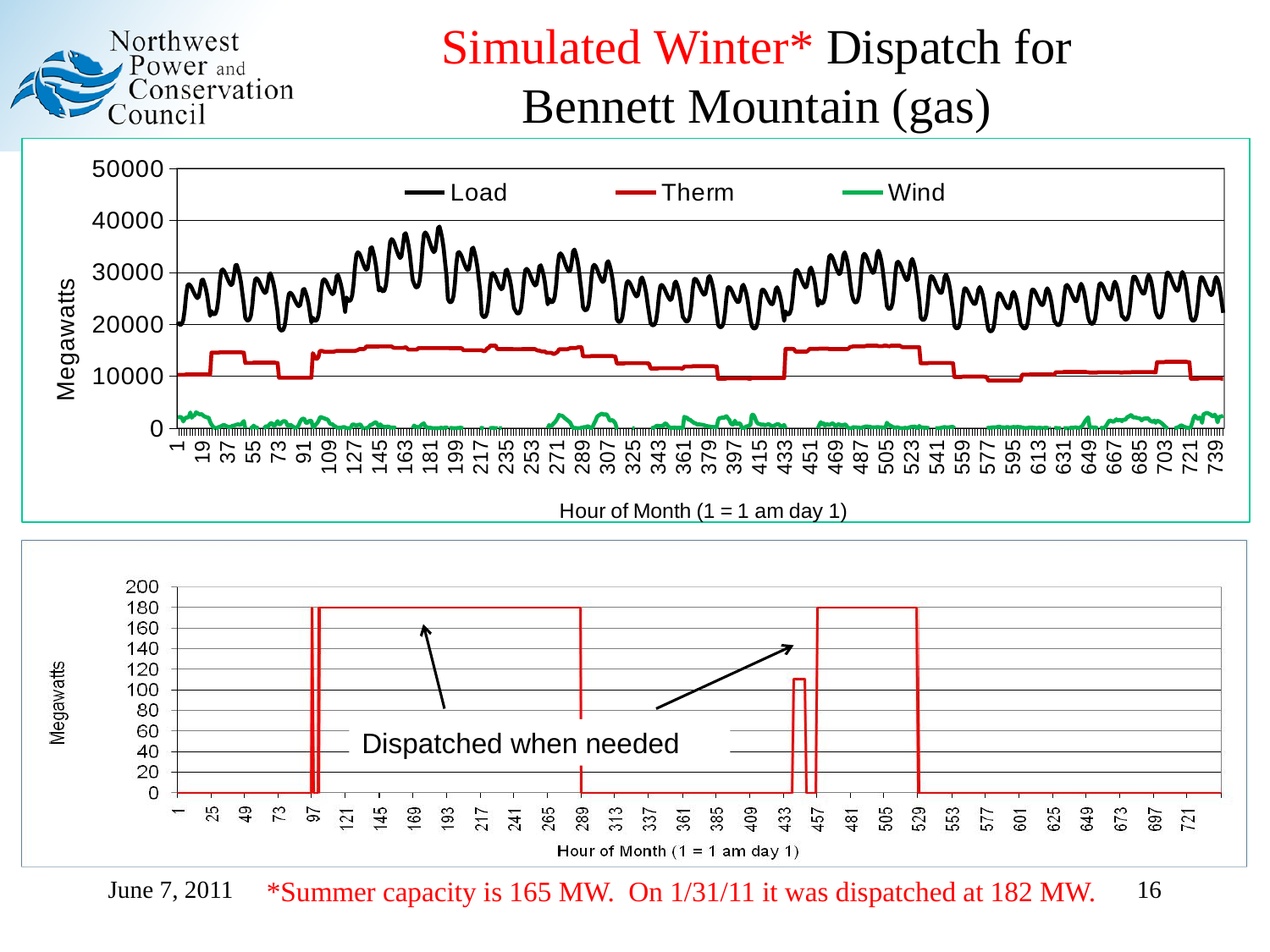
In the top chart, is the Wind value at hour 289 greater or less than 10000? less In the top chart, which series has the lowest values throughout the month? Wind In the top chart, which is larger at hour 469, Load or Therm? Load In the bottom chart, what is the dispatched value at hour 601? 0 In the top chart, is the Therm value at hour 181 greater or less than 20000? less In the top chart, which series has the highest values throughout the month, Load, Therm or Wind? Load How many series does the legend of the top chart list? 3 What is the x-axis title of the bottom chart? Hour of Month (1 = 1 am day 1) In the bottom chart, is the dispatched value at hour 193 greater or less than 160? greater In the top chart, which series is plotted in green? Wind What kind of chart is the top chart on the slide? line chart